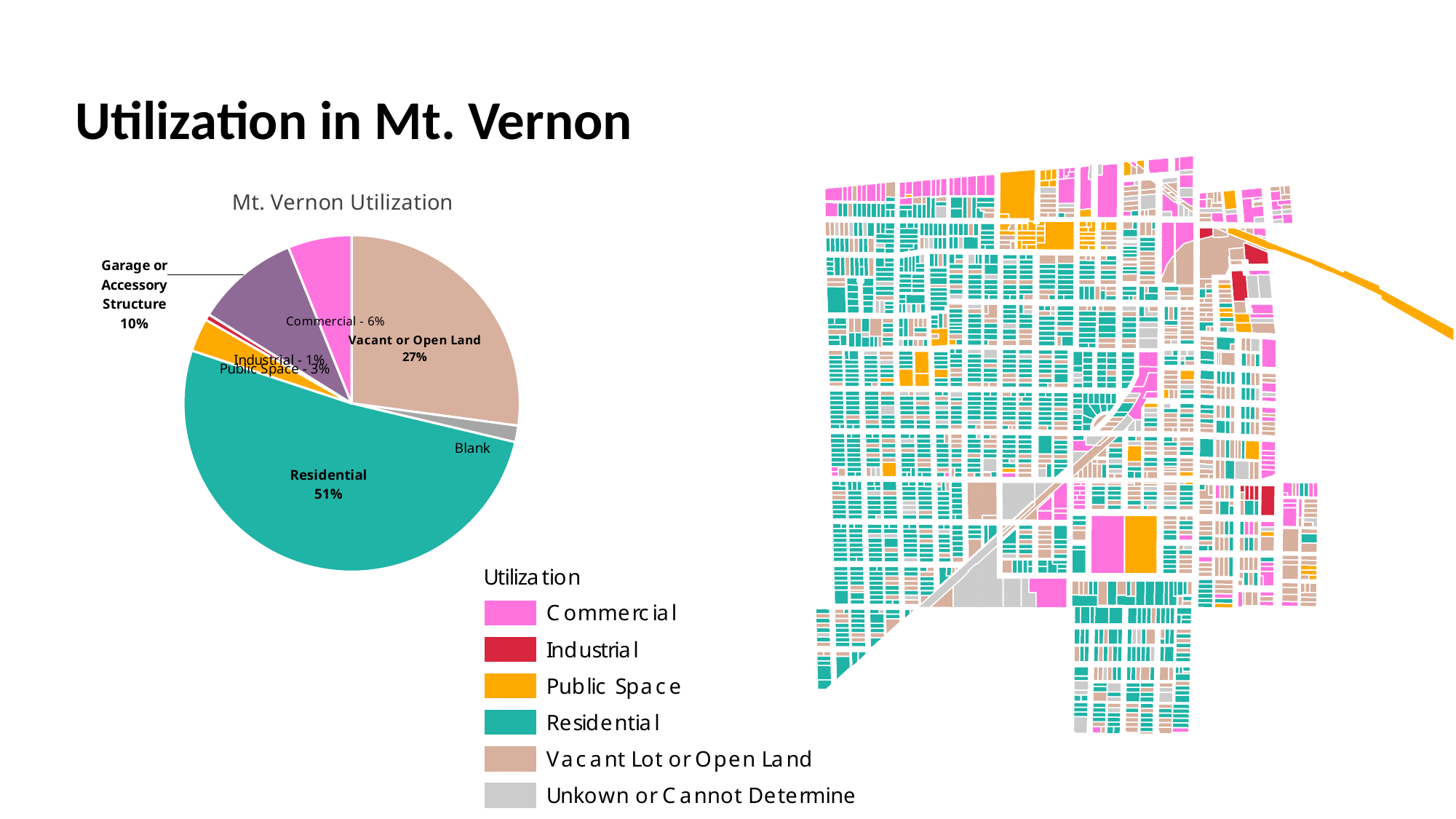
Which labelled category has the smallest slice in the Mt. Vernon Utilization pie chart? Industrial In the Mt. Vernon Utilization pie chart, what percentage is Commercial? 6% In the Mt. Vernon Utilization pie chart, which is larger: Garage or Accessory Structure or Commercial? Garage or Accessory Structure Which category has the largest slice in the Mt. Vernon Utilization pie chart? Residential How many slices does the Mt. Vernon Utilization pie chart have? 7 In the Mt. Vernon Utilization pie chart, how many percentage points larger is Residential than Vacant or Open Land? 24 In the Mt. Vernon Utilization pie chart, what percentage is Public Space? 3% In the Mt. Vernon Utilization pie chart, what percentage is Industrial? 1% In the Mt. Vernon Utilization pie chart, what percentage is Garage or Accessory Structure? 10% In the Mt. Vernon Utilization pie chart, what percentage is Vacant or Open Land? 27% In the Mt. Vernon Utilization pie chart, what percentage is Residential? 51% What type of chart is shown under the title "Mt. Vernon Utilization"? pie chart